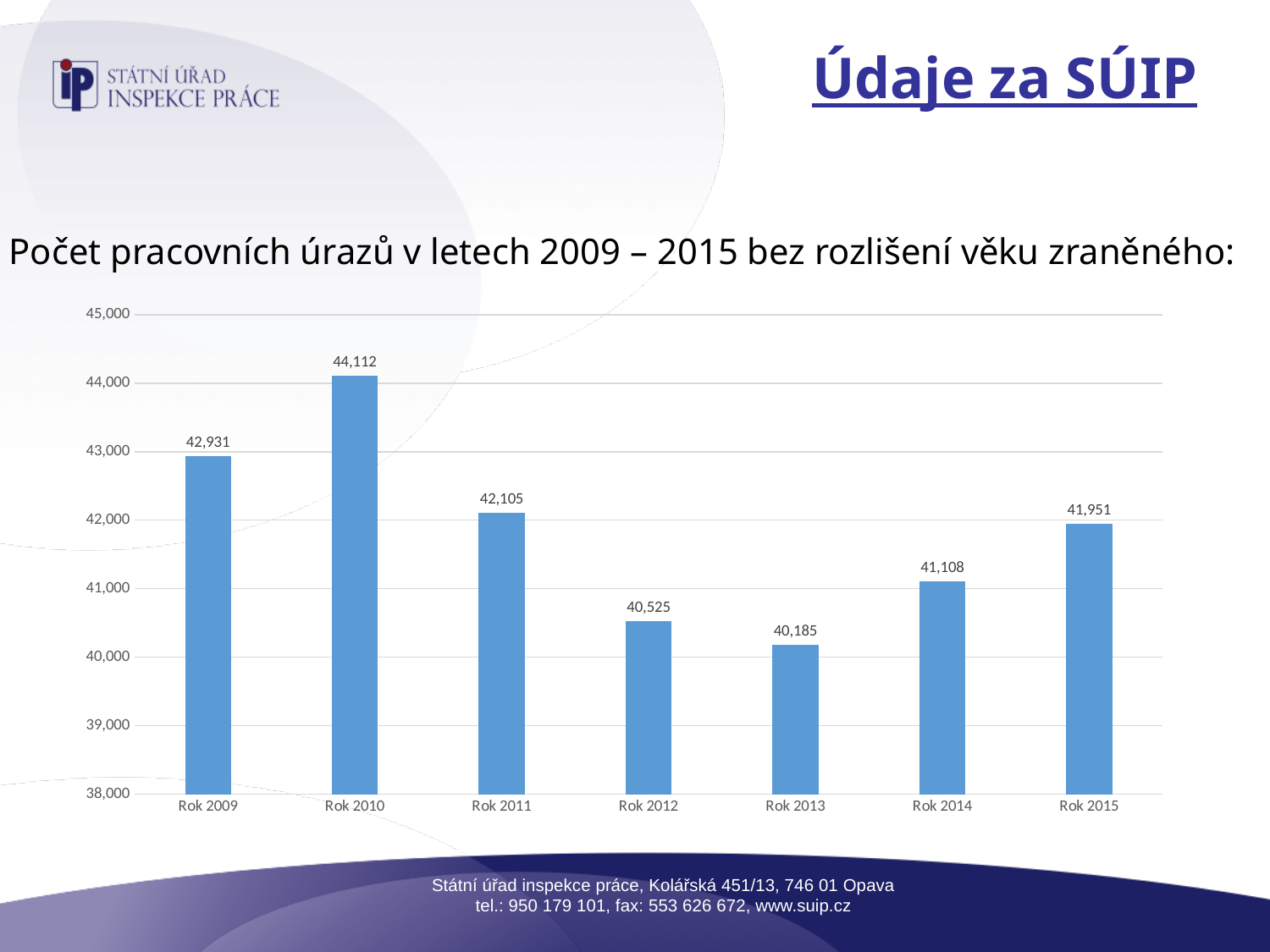
Is the value for Rok 2014 greater or less than 42,000? less How many years are shown on the x axis? 7 Do the values rise or fall from Rok 2013 to Rok 2015? rise What is the value for Rok 2013? 40,185 What is the value for Rok 2010? 44,112 What is the difference between the values for Rok 2015 and Rok 2014? 843 Which is larger, the value for Rok 2011 or the value for Rok 2012? Rok 2011 What is the difference between the values for Rok 2010 and Rok 2009? 1,181 Which year has the highest value? Rok 2010 What kind of chart is shown on the slide? bar chart Which year has the lowest value? Rok 2013 What is the value for Rok 2015? 41,951